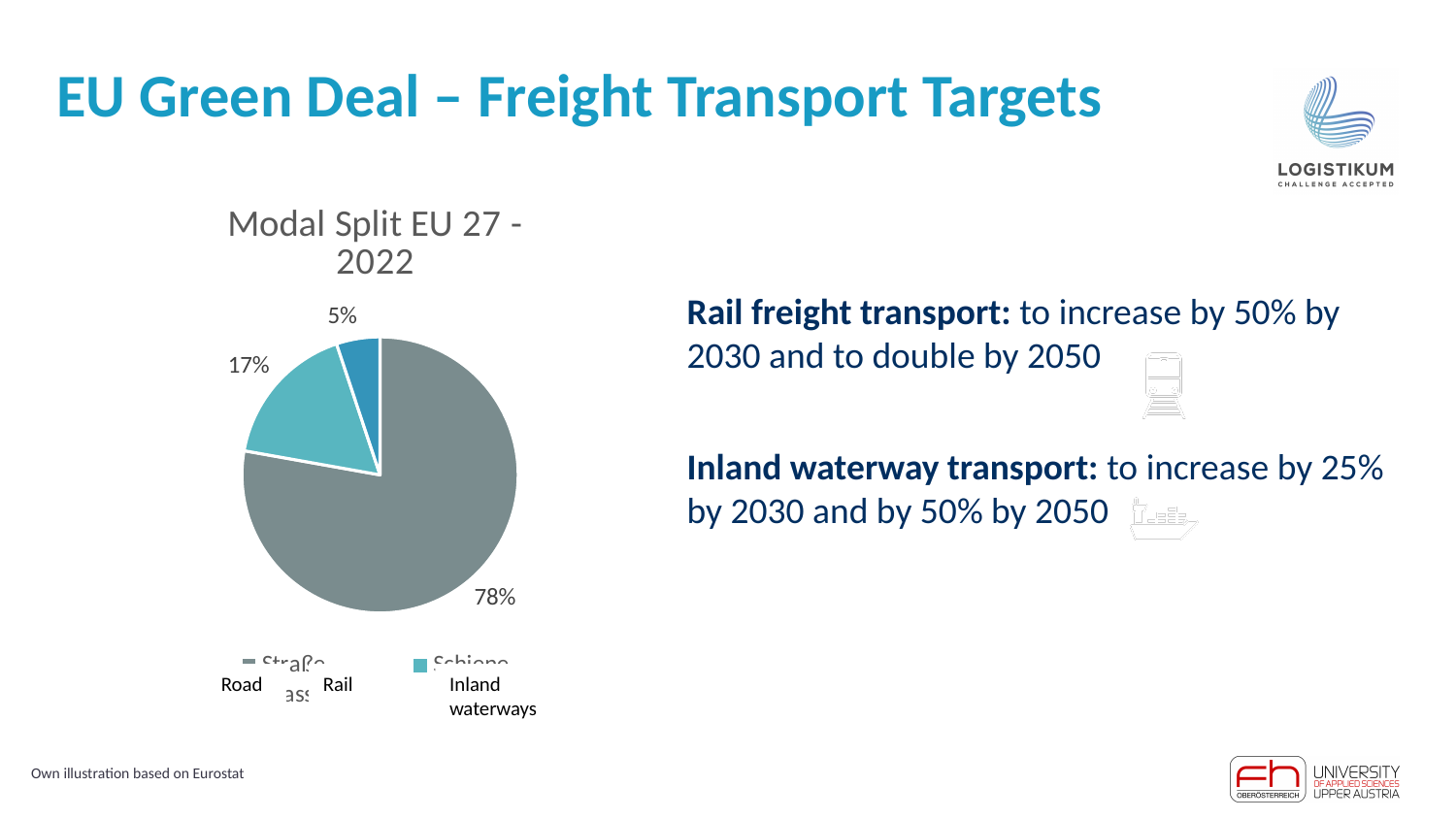
What is the combined share of Rail and Inland waterways? 22% What share of the modal split do Inland waterways account for? 5% What is the difference in percentage points between the Rail share and the Inland waterways share? 12 Which transport mode has the smallest share in the pie chart? Inland waterways How many slices does the pie chart have? 3 What kind of chart is shown on the slide? pie chart What is the title of the pie chart? Modal Split EU 27 - 2022 Which transport mode has the largest share in the pie chart? Road Which has a larger share, Rail or Inland waterways? Rail What share of the modal split does Rail account for? 17% What is the difference in percentage points between the Road share and the Rail share? 61 What share of the modal split does Road account for? 78%